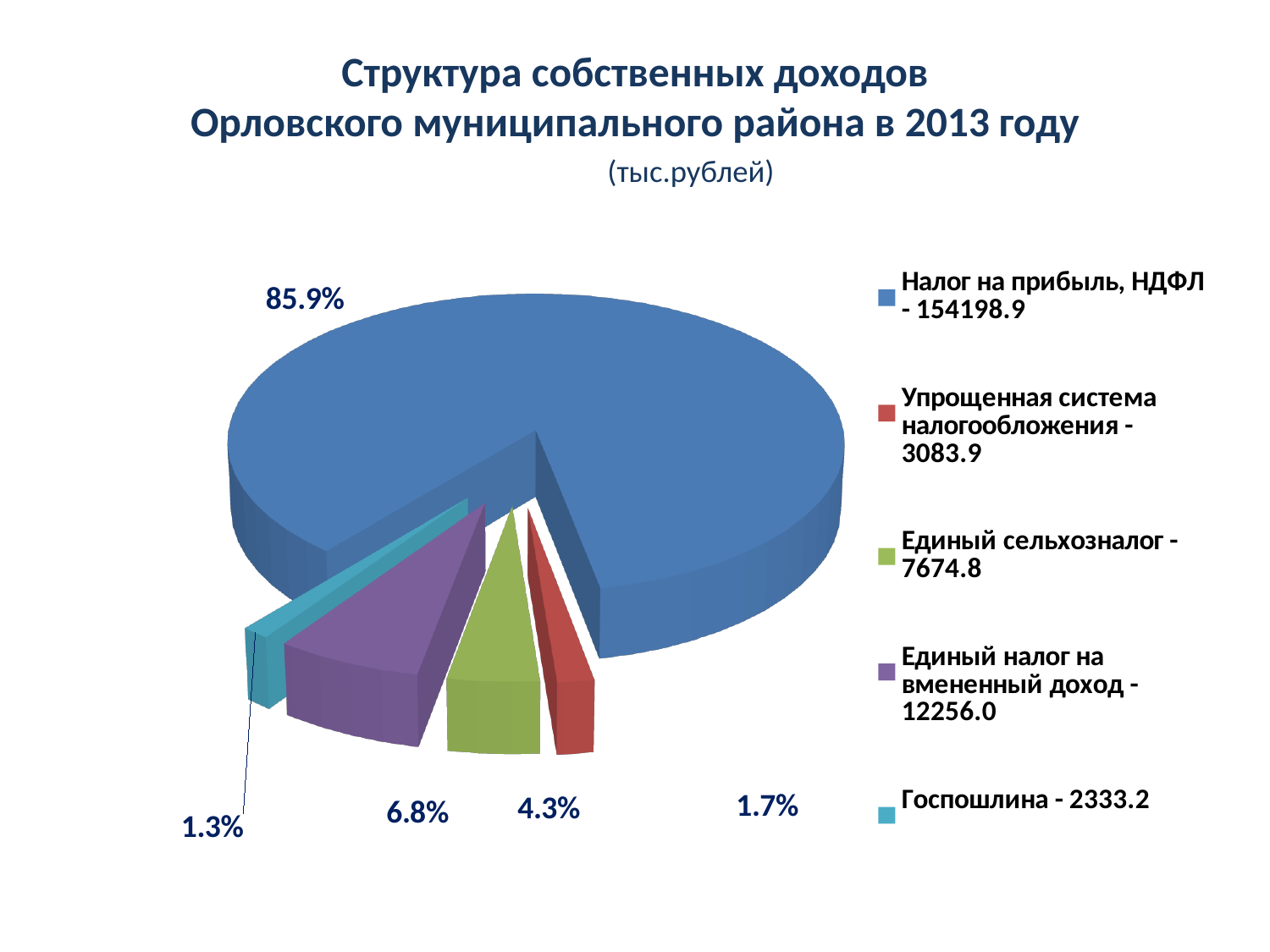
What is the difference in percentage points between the shares of "Единый налог на вмененный доход" and "Единый сельхозналог"? 2.5% What share of the pie does "Налог на прибыль, НДФЛ" represent? 85.9% What kind of chart is shown on the slide? Pie chart Which is larger: the share for "Единый сельхозналог" or the share for "Упрощенная система налогообложения"? Единый сельхозналог What share of the pie does "Единый налог на вмененный доход" represent? 6.8% Which category has the smallest share of the pie? Госпошлина What share of the pie does "Единый сельхозналог" represent? 4.3% What value is given in the legend for "Единый налог на вмененный доход"? 12256.0 Which category has the largest share of the pie? Налог на прибыль, НДФЛ How many slices does the pie chart have? 5 What value is given in the legend for "Упрощенная система налогообложения"? 3083.9